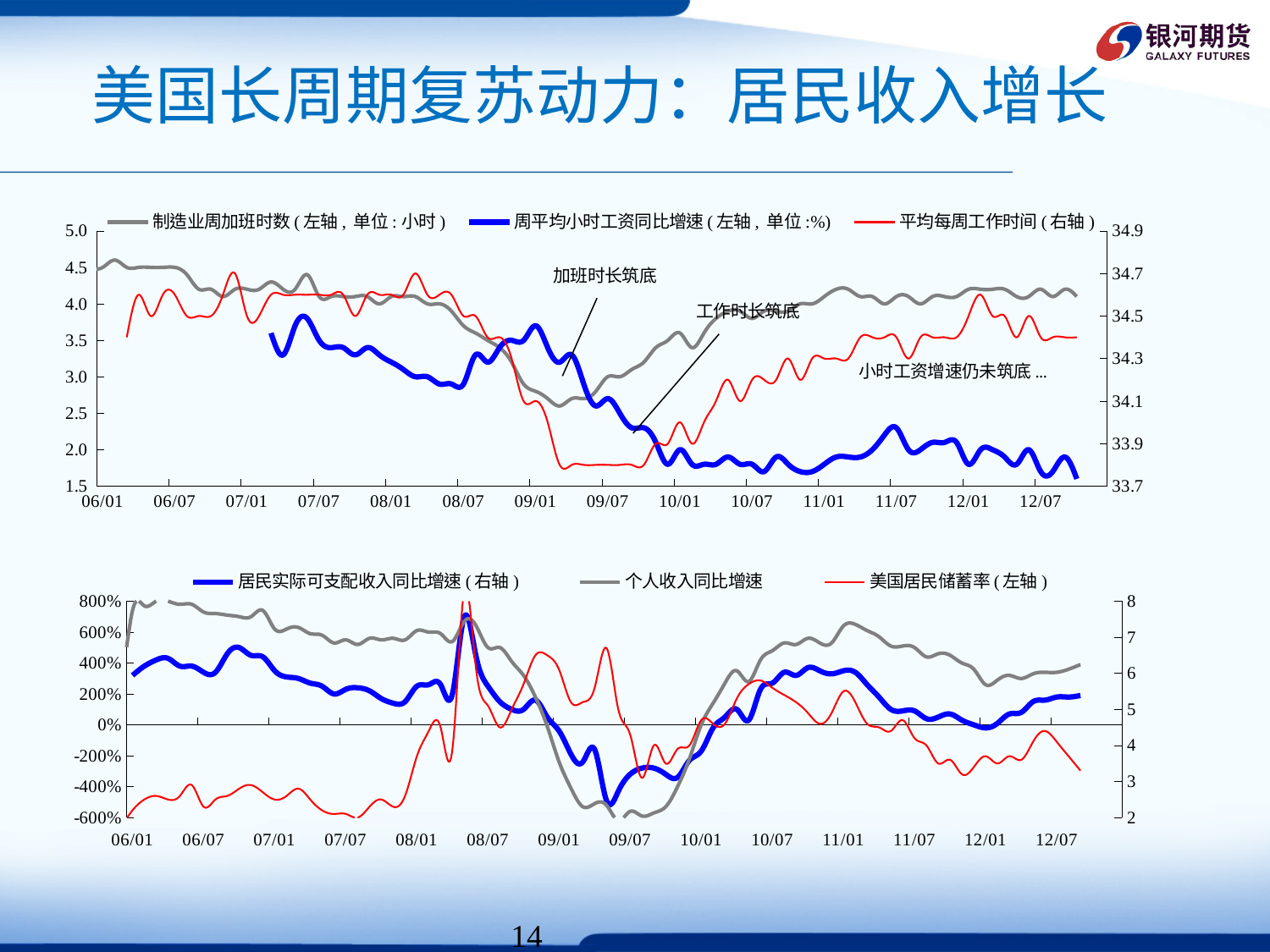
In the top chart, is the value of 周平均小时工资同比增速 at 12/07 greater or less than 2.5? less How many series does the legend of the top chart list? 3 What kind of chart is the top chart on the slide? line chart In the bottom chart, does 个人收入同比增速 rise or fall between 09/07 and 11/01? rise What kind of chart is the bottom chart on the slide? line chart In the bottom chart, which series is plotted on the right axis according to the legend? 居民实际可支配收入同比增速（右轴） In the top chart, does 周平均小时工资同比增速 rise or fall between 09/01 and 10/01? fall In the top chart, is the value of 制造业周加班时数 at 06/01 greater or less than 4.0? greater How many series does the legend of the bottom chart list? 3 In the top chart, is the value of 平均每周工作时间 at 09/07 greater or less than 34.1 on the right axis? less In the top chart, which series is drawn in blue? 周平均小时工资同比增速（左轴，单位:%）